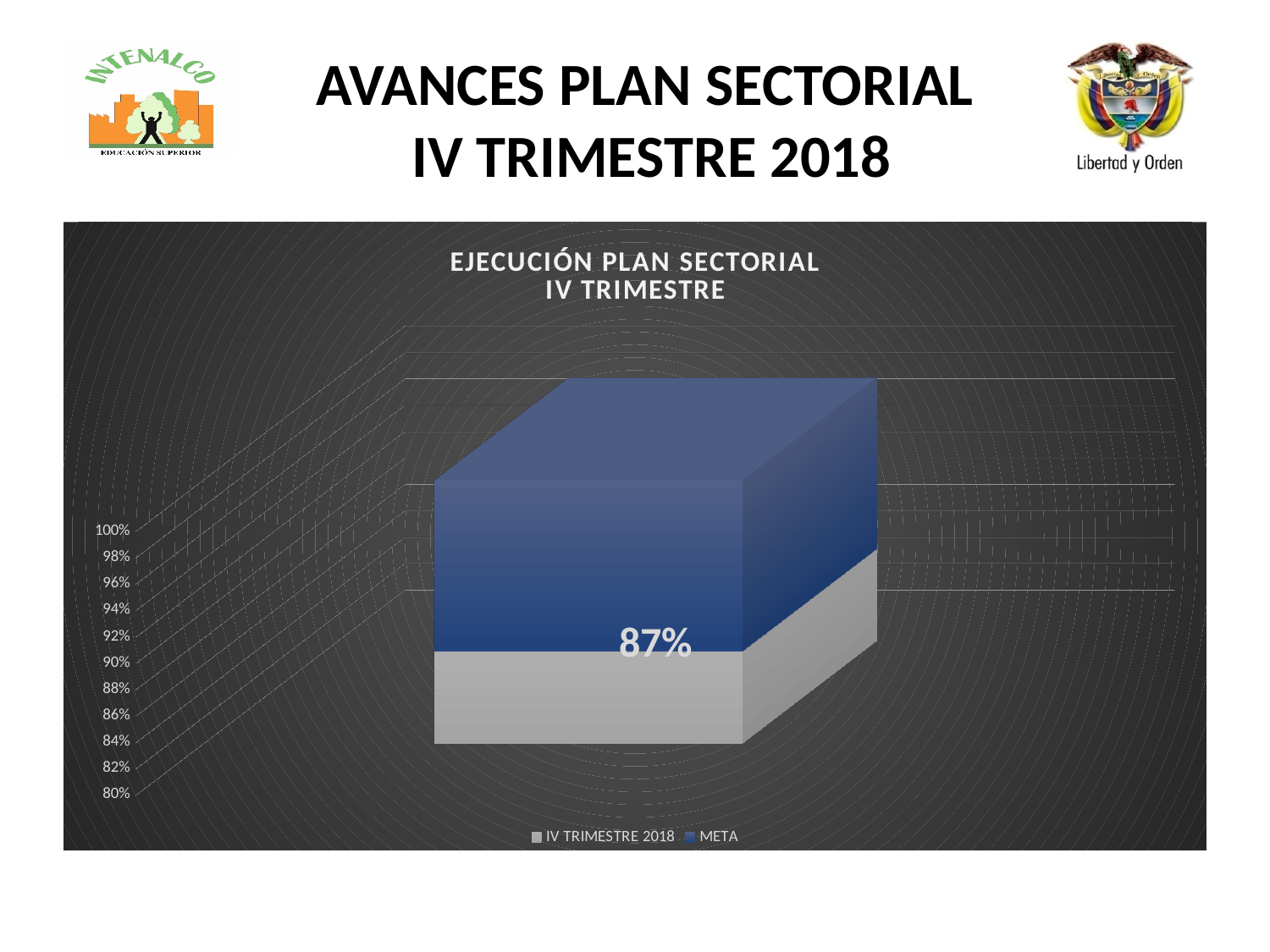
What value is shown for IV TRIMESTRE 2018 in the EJECUCIÓN PLAN SECTORIAL IV TRIMESTRE chart? 87% What is the highest value shown on the vertical axis of the chart? 100% How many series does the legend of the chart list? 2 What is the lowest value shown on the vertical axis of the chart? 80% What kind of chart is shown on the slide? Bar chart Is the value for IV TRIMESTRE 2018 greater or less than 90%? less What is the title of the chart on the slide? EJECUCIÓN PLAN SECTORIAL IV TRIMESTRE Which series is shown in blue in the chart? META